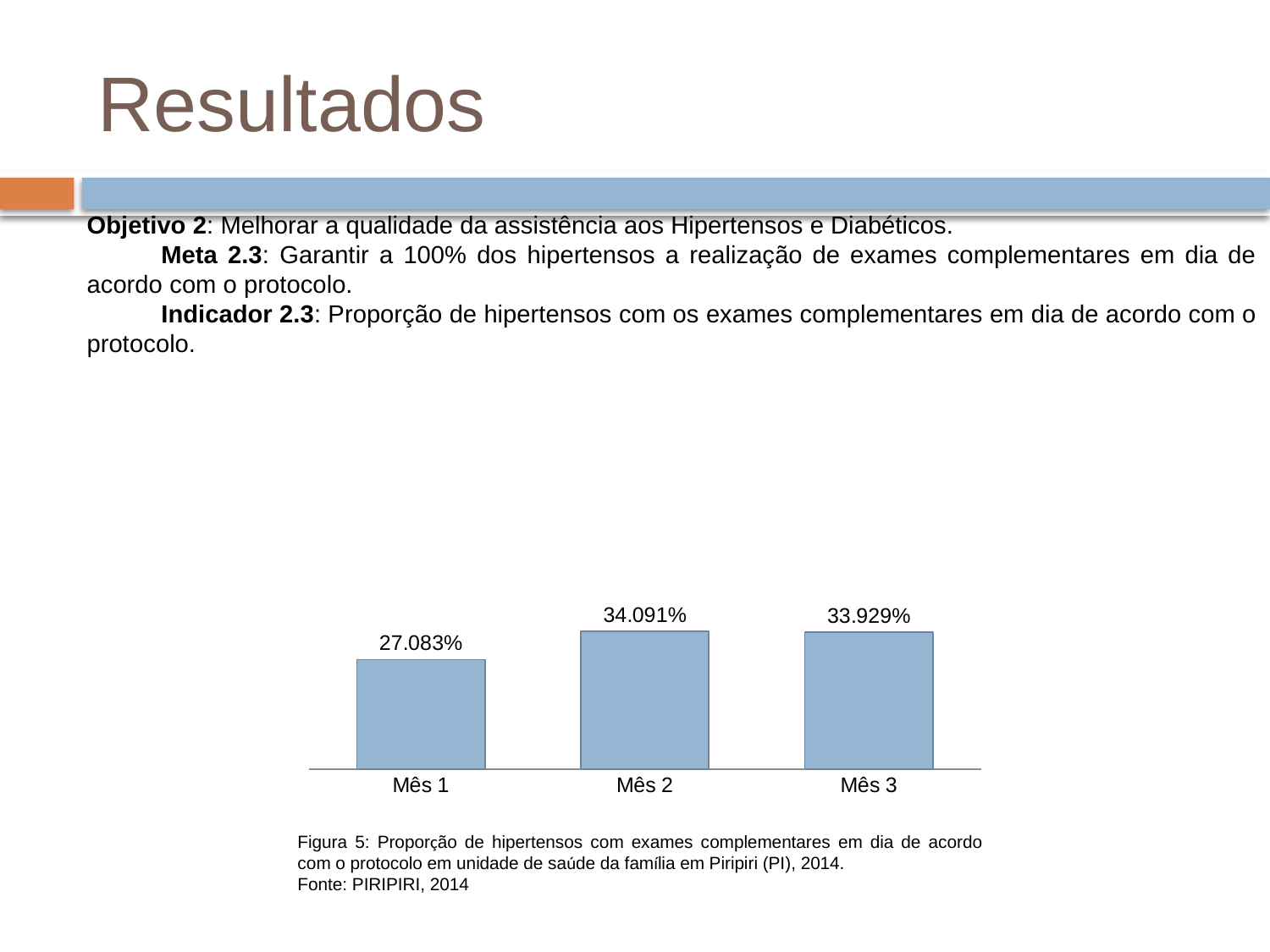
What is the value for Mês 1? 27.083% What is the value for Mês 2? 34.091% Which month has the highest value? Mês 2 How many months are shown on the chart? 3 What kind of chart is shown on the slide? Bar chart What is the value for Mês 3? 33.929% What is the difference between the values for Mês 2 and Mês 1? 7.008% Which is larger, the value for Mês 1 or the value for Mês 3? Mês 3 What figure number is given in the caption below the chart? Figura 5 Does the value rise or fall from Mês 1 to Mês 2? Rise What is the difference between the values for Mês 3 and Mês 1? 6.846% Which month has the lowest value? Mês 1